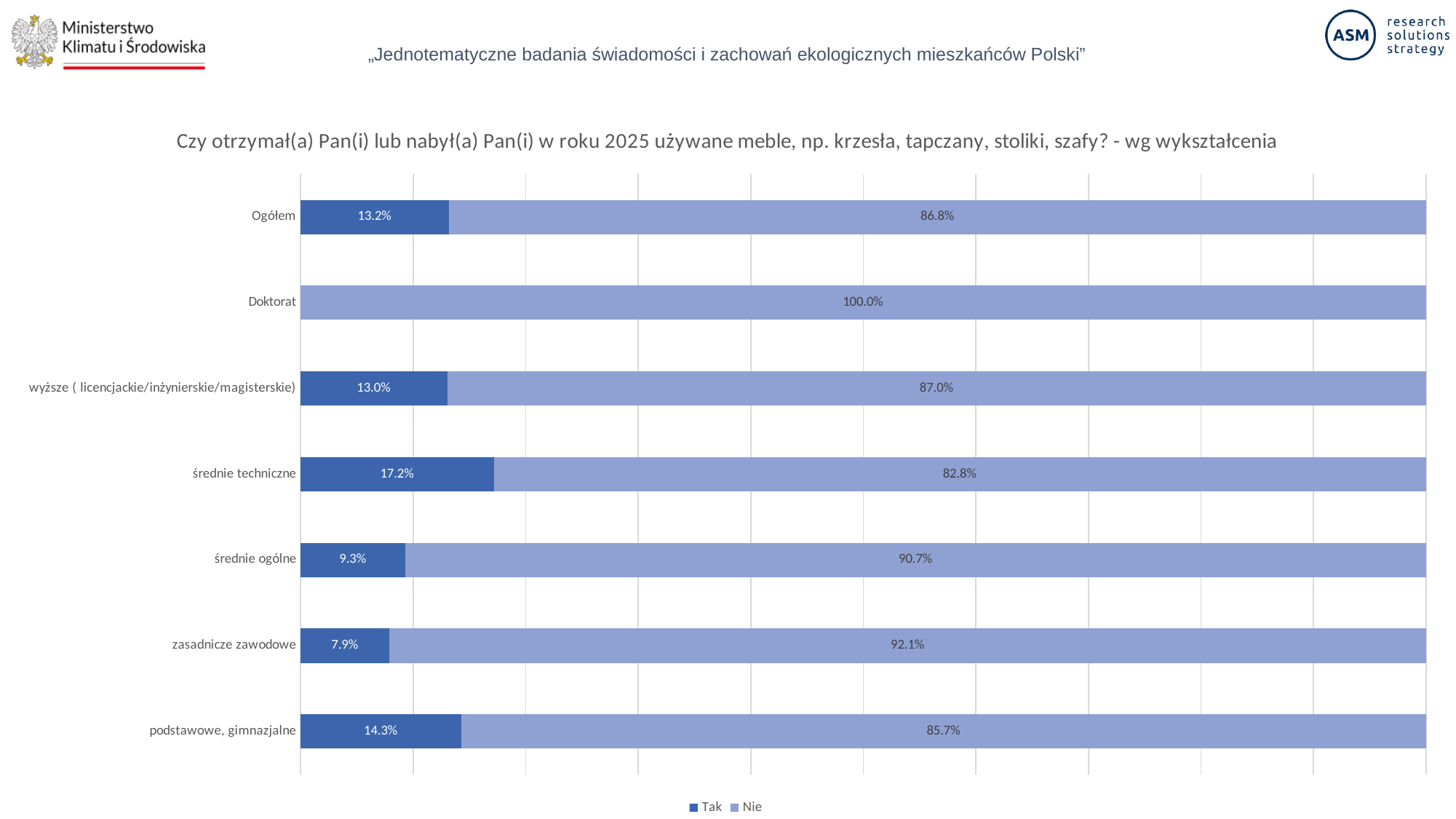
What is the "Tak" value for "średnie techniczne"? 17.2% What are the two series named in the legend? Tak, Nie What is the "Nie" value for "zasadnicze zawodowe"? 92.1% What is the "Tak" value for "Ogółem"? 13.2% What kind of chart is shown on the slide? bar chart What is the "Nie" value for "Doktorat"? 100.0% Which category has the highest "Tak" value? średnie techniczne How many categories are shown on the chart? 7 How many series does the legend list? 2 Which is larger: the "Tak" value for "średnie ogólne" or for "podstawowe, gimnazjalne"? podstawowe, gimnazjalne What is the difference between the "Tak" values for "podstawowe, gimnazjalne" and "zasadnicze zawodowe"? 6.4% Which category has the lowest "Nie" value? średnie techniczne